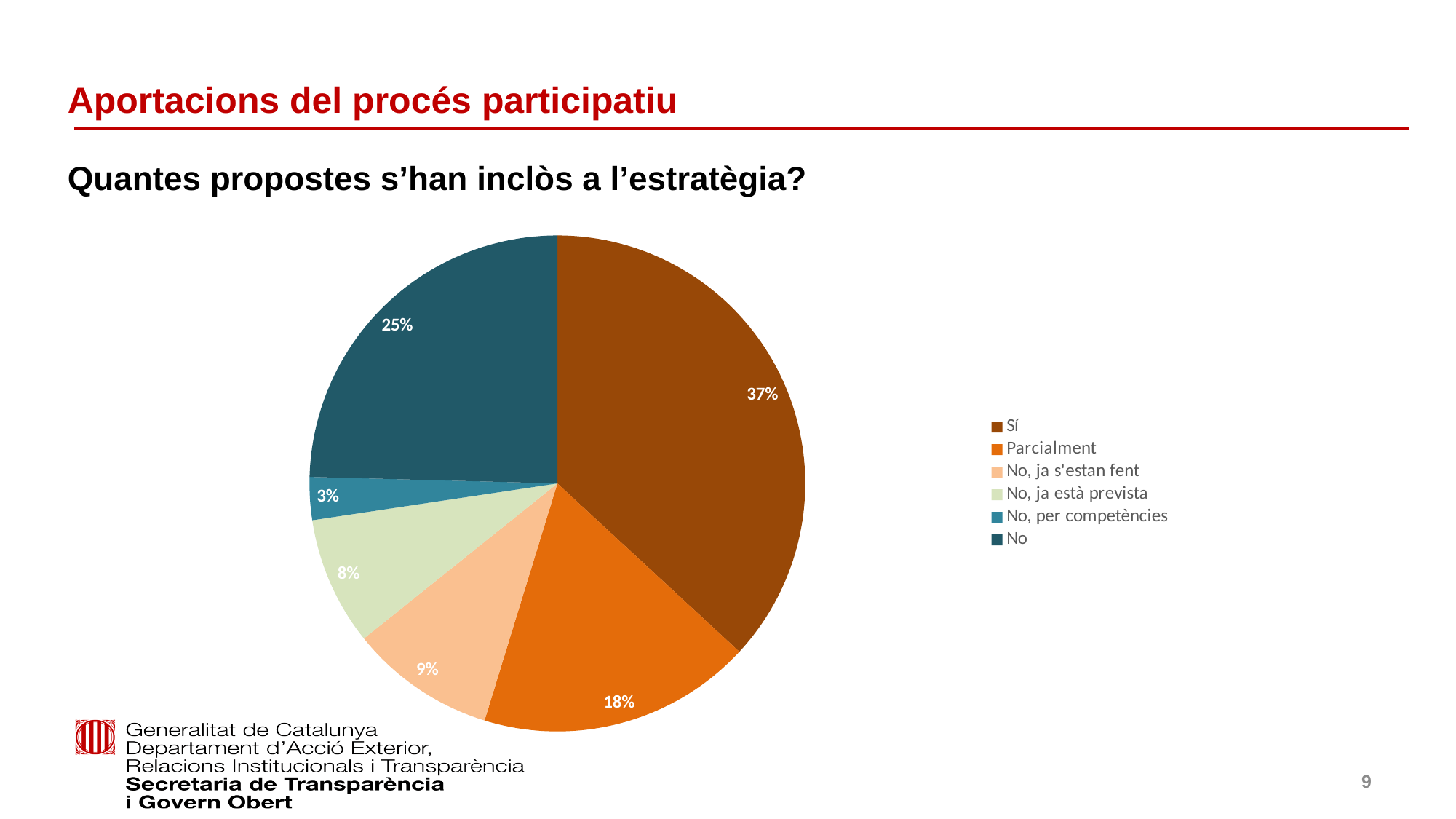
What share of the pie does the "No, ja s'estan fent" slice represent? 9% What kind of chart is shown on the slide? pie chart What is the difference in percentage points between the "Sí" slice and the "No" slice? 12 What share of the pie does the "No, per competències" slice represent? 3% What share of the pie does the "No, ja està prevista" slice represent? 8% How many categories does the legend list? 6 Which category has the smallest slice of the pie? No, per competències Which category has the largest slice of the pie? Sí Which is larger, the "Parcialment" slice or the "No" slice? No